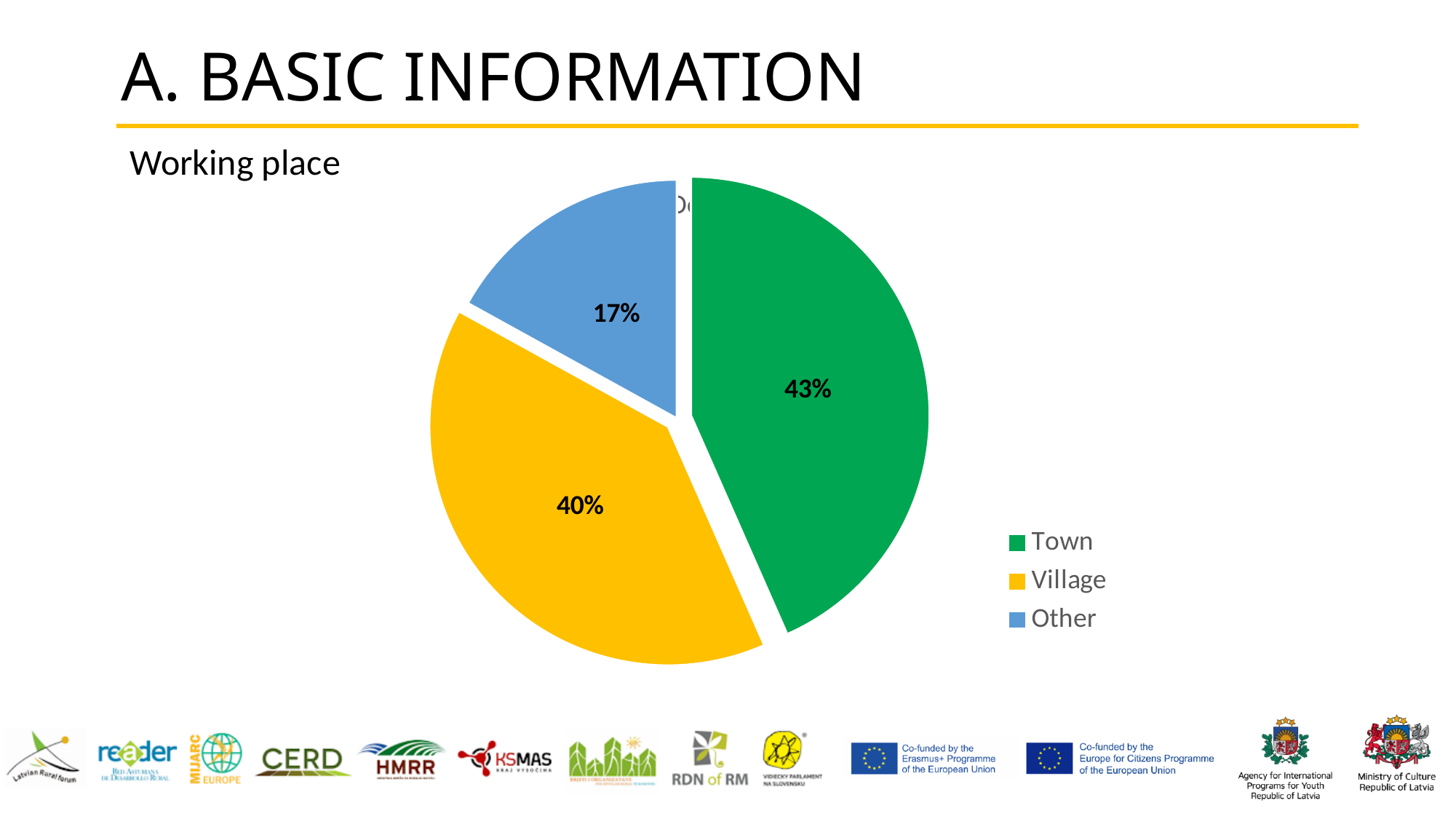
What kind of chart is shown on the slide? Pie chart What colour is the Village slice in the pie chart? Yellow What is the heading above the pie chart? Working place Which category has the largest slice of the pie? Town What share of the pie does Village account for? 40% Which is larger, the Village slice or the Other slice? Village What share of the pie does Town account for? 43% What is the difference in percentage points between the Town and Village slices? 3 Which category has the smallest slice of the pie? Other What is the difference in percentage points between the Village and Other slices? 23 What share of the pie does Other account for? 17% How many categories are shown in the pie chart? 3